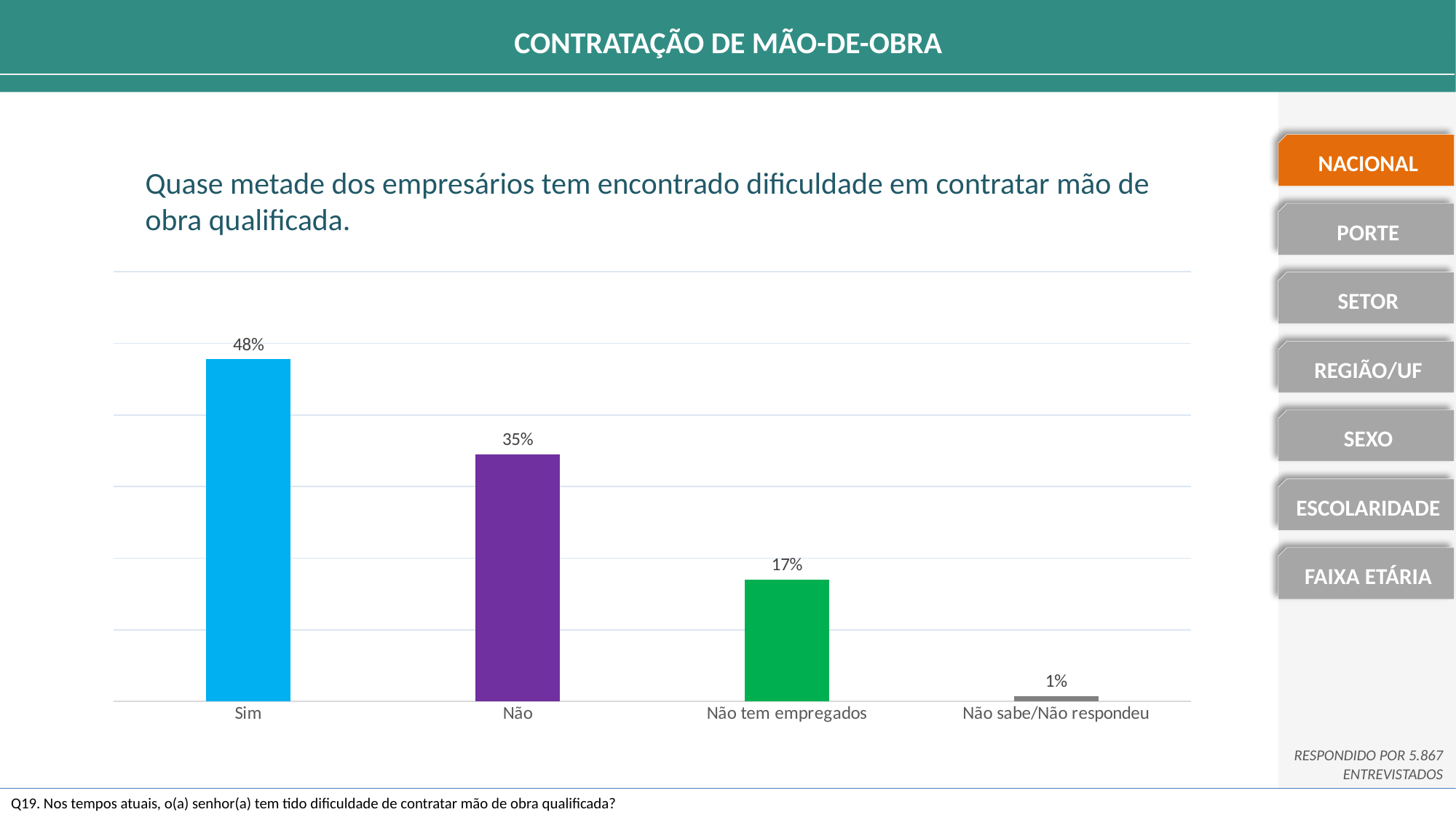
Which category has the highest value? Sim What is the difference between the values for "Sim" and "Não"? 13% What is the value for "Sim"? 48% What colour is the bar for "Não tem empregados"? Green What is the value for "Não tem empregados"? 17% What kind of chart is shown on the slide? Bar chart Which category has the lowest value? Não sabe/Não respondeu How many categories are shown on the x axis? 4 What is the value for "Não sabe/Não respondeu"? 1% What is the value for "Não"? 35% Do the values rise or fall from left to right along the x axis? Fall Which is larger, the value for "Não" or the value for "Não tem empregados"? Não